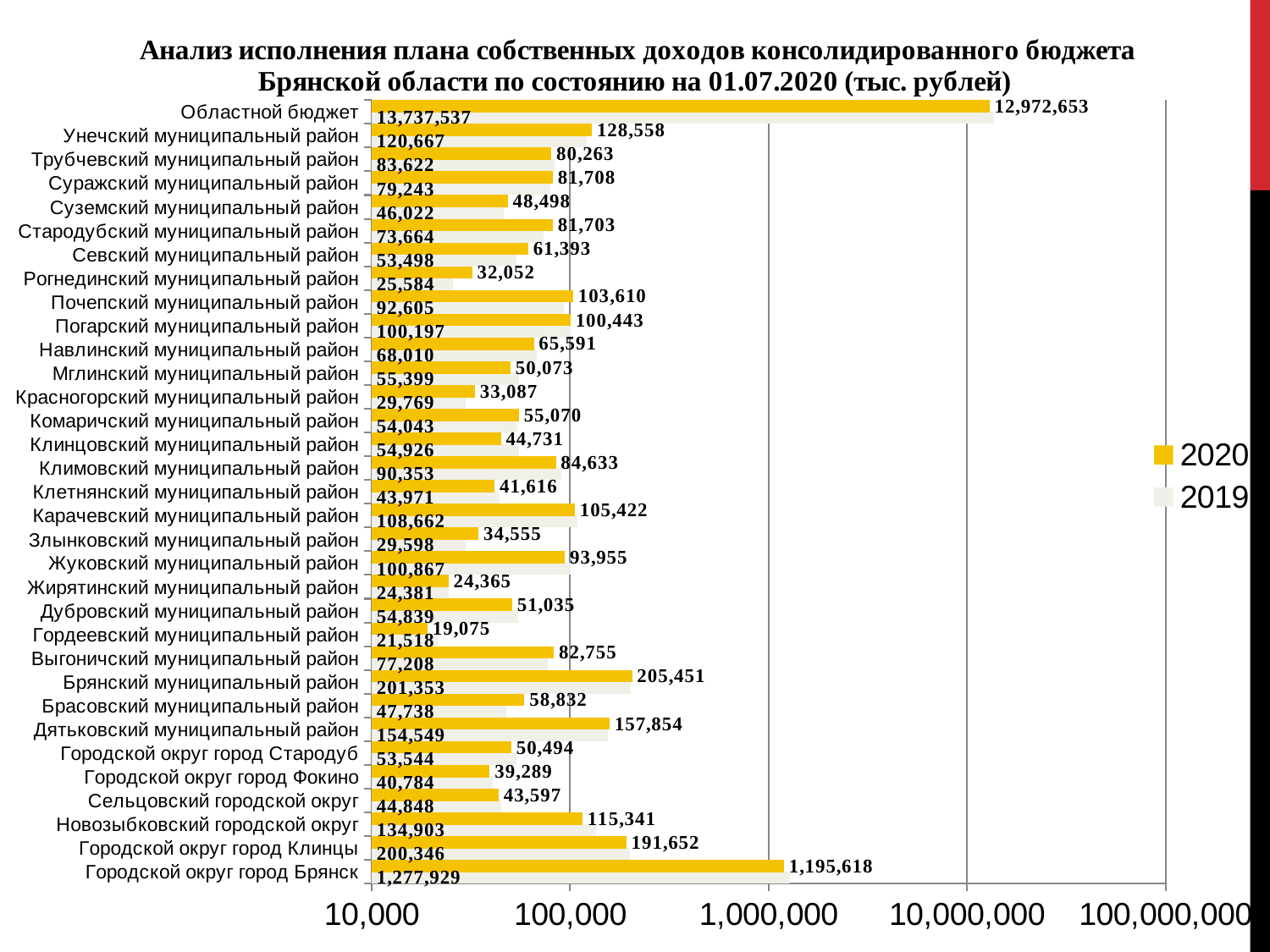
What is the 2019 value for Дятьковский муниципальный район? 154,549 What is the 2019 value for Городской округ город Брянск? 1,277,929 What is the 2020 value for Унечский муниципальный район? 128,558 Which category has the highest 2020 value? Областной бюджет What is the difference between the 2019 and 2020 values for Областной бюджет? 764,884 Is the 2020 value for Рогнединский муниципальный район greater or less than 100,000? less What kind of chart is shown on the slide? bar chart How many series does the legend list? 2 What is the difference between the 2020 and 2019 values for Брянский муниципальный район? 4,098 Which has the larger 2020 value: Брянский муниципальный район or Городской округ город Клинцы? Брянский муниципальный район What colour represents the 2020 series in the legend? yellow Which category has the lowest 2020 value? Гордеевский муниципальный район